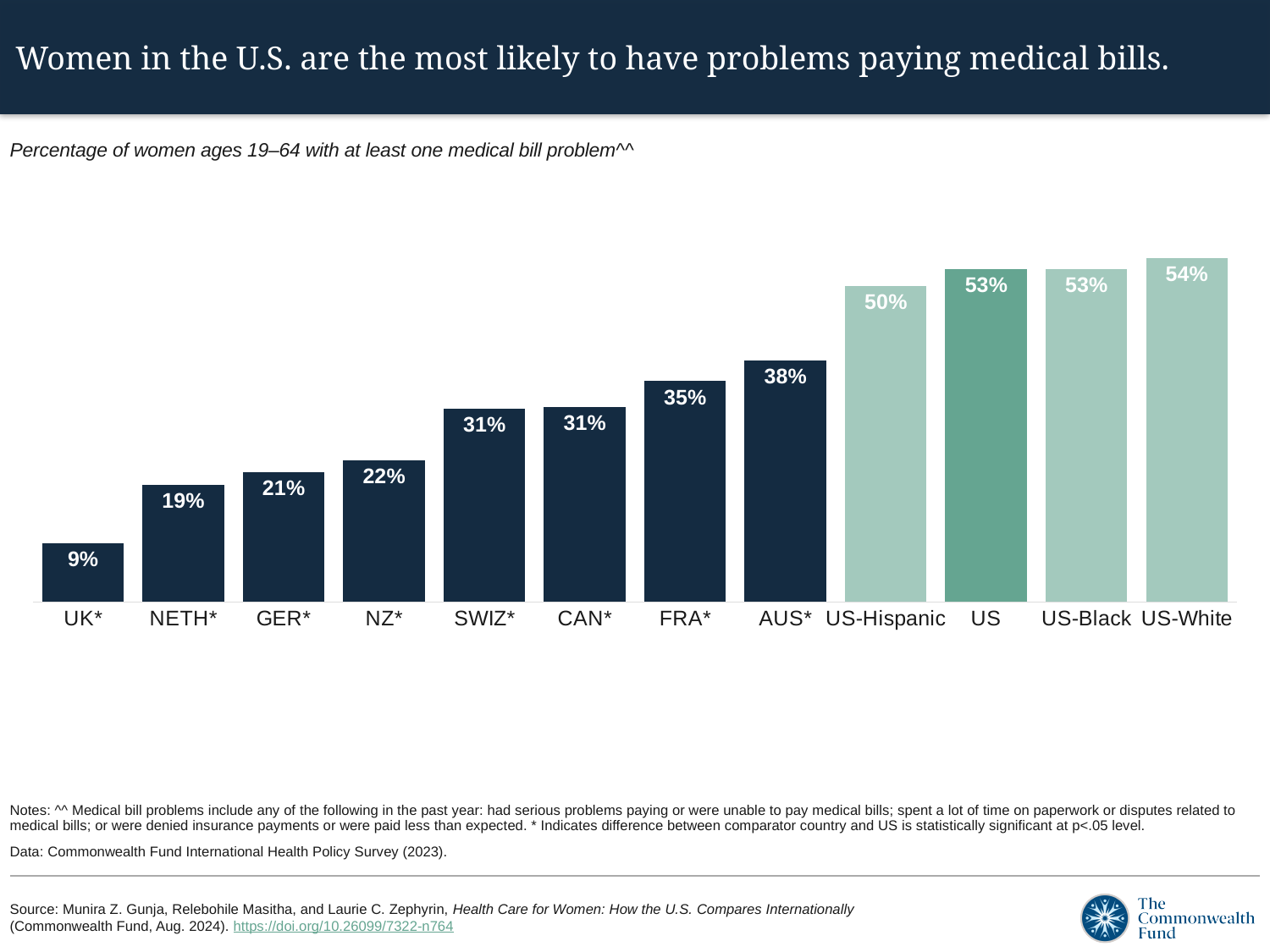
What is the value for US-Hispanic? 50% Which is larger, the value for FRA* or the value for NZ*? FRA* What is the value for AUS*? 38% What kind of chart is this? Bar chart What is the difference between the values for GER* and NETH*? 2% What is the difference between the values for US and AUS*? 15% Which category has the lowest value? UK* What is the value for UK*? 9% Which category has the highest value? US-White Do the values generally rise or fall from left to right along the x axis? Rise What is the subtitle describing what the chart measures? Percentage of women ages 19–64 with at least one medical bill problem^^ How many categories are shown on the x axis? 12